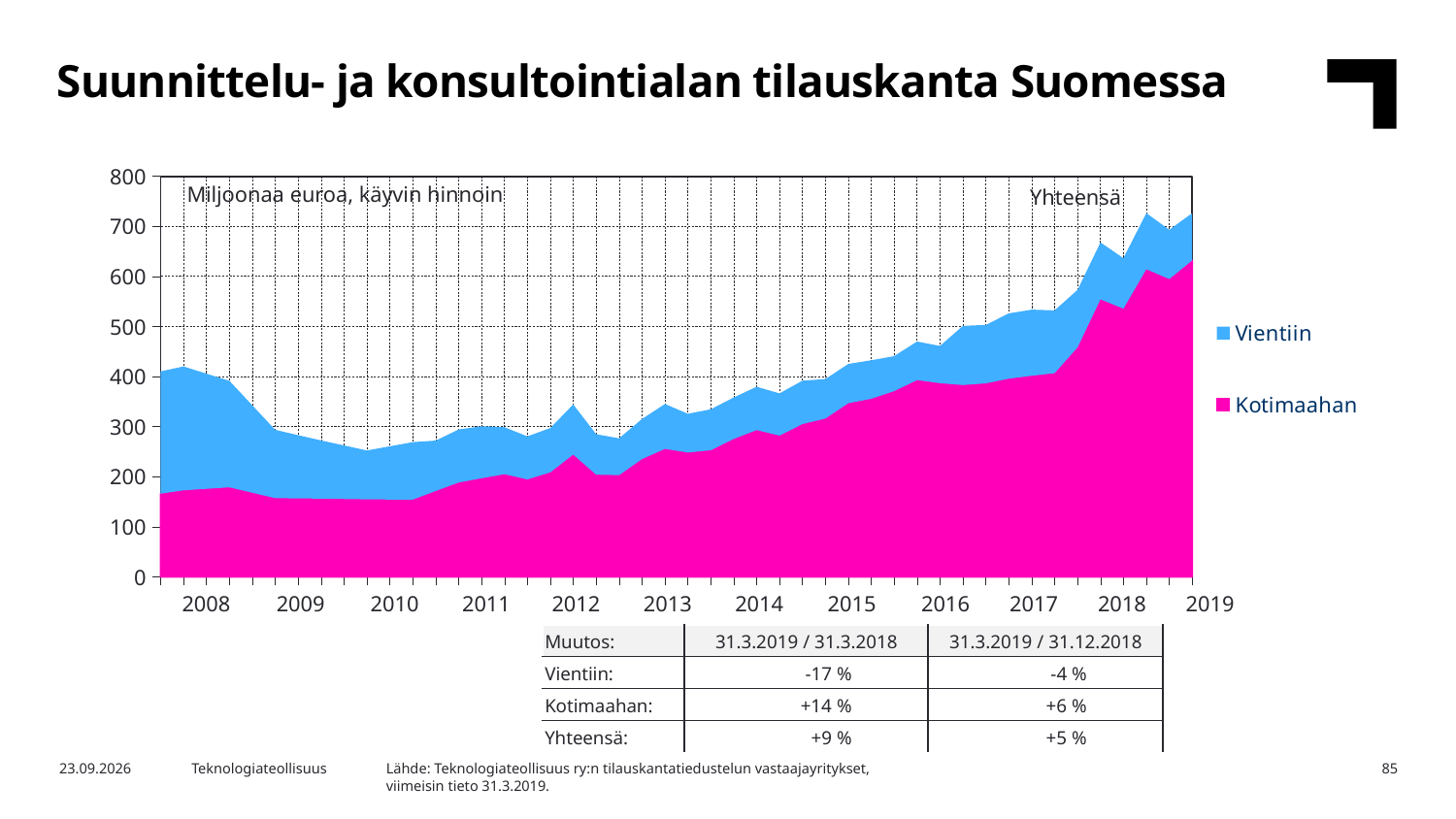
Is the Kotimaahan value at the end of the series in 2019 greater or less than 600? greater How many years are labelled on the x axis of the chart? 12 What unit is stated in the label inside the chart area? Miljoonaa euroa, käyvin hinnoin How many series does the chart legend list? 2 Does the Kotimaahan series generally rise or fall from 2010 to 2019? rise What kind of chart is shown on the slide? Stacked area chart Is the total (Yhteensä) value at the start of 2008 greater or less than 400? greater At the end of the series in 2019, which is larger, the Vientiin portion or the Kotimaahan portion? Kotimaahan Is the Kotimaahan value at the start of 2008 greater or less than 200? less What are the two series named in the chart legend? Vientiin and Kotimaahan